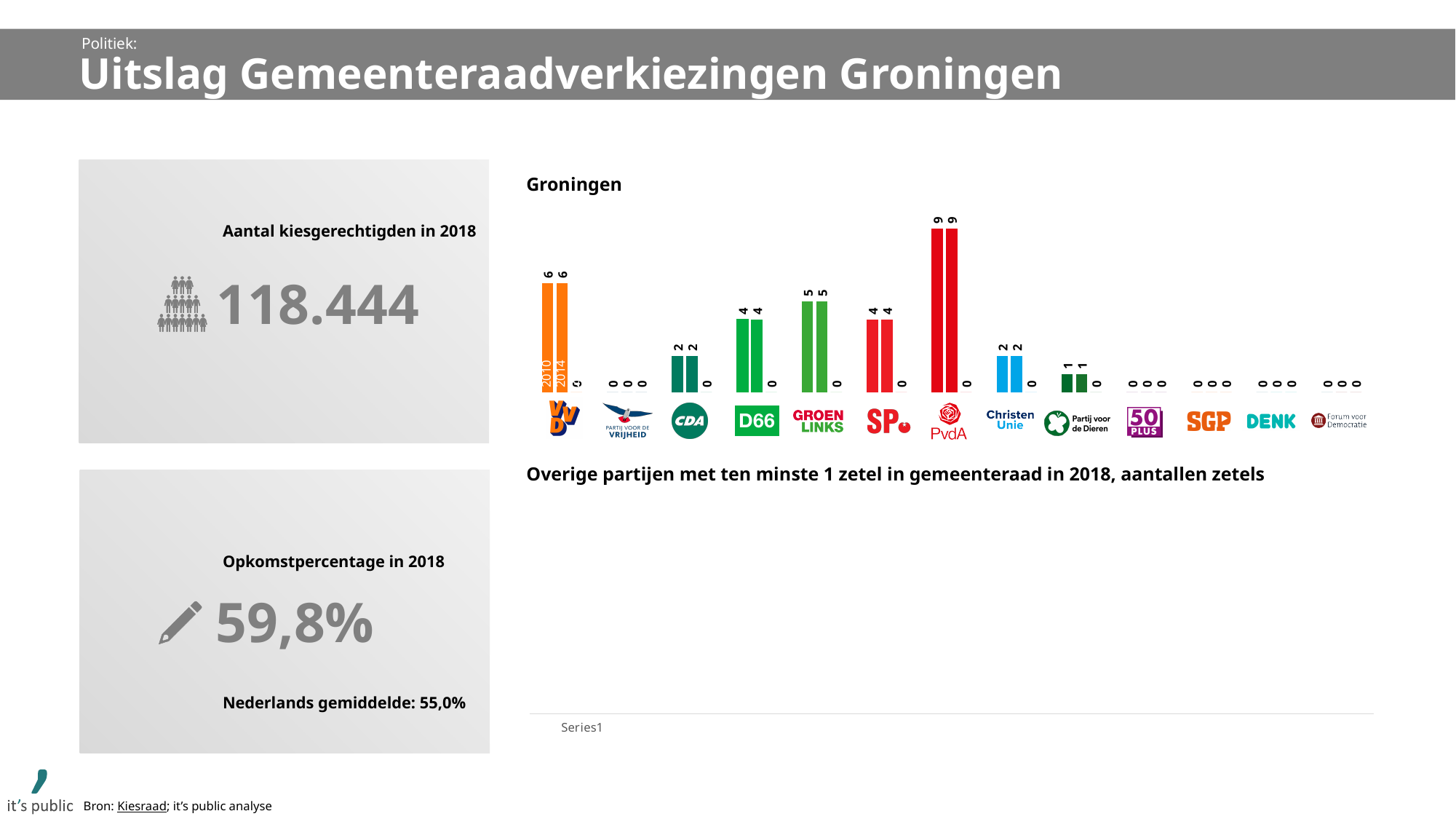
What is the title of the bar chart on the slide? Groningen In the Groningen chart, what is the 2010 value for GroenLinks? 5 In the Groningen chart, how many seats did VVD have in 2014? 6 In the Groningen chart, what is the difference between the 2010 seats of PvdA and VVD? 3 What kind of chart is the Groningen chart? bar chart In the Groningen chart, which party had more seats in 2014, D66 or CDA? D66 In the Groningen chart, how many seats did SGP have in 2014? 0 In the Groningen chart, how many seats did PvdA have in 2010? 9 In the Groningen chart, which party has the highest number of seats in 2014? PvdA In the Groningen chart, what is the 2014 value for Partij voor de Dieren? 1 In the Groningen chart, how many seats did ChristenUnie have in 2010? 2 How many parties are shown along the x axis of the Groningen chart? 13